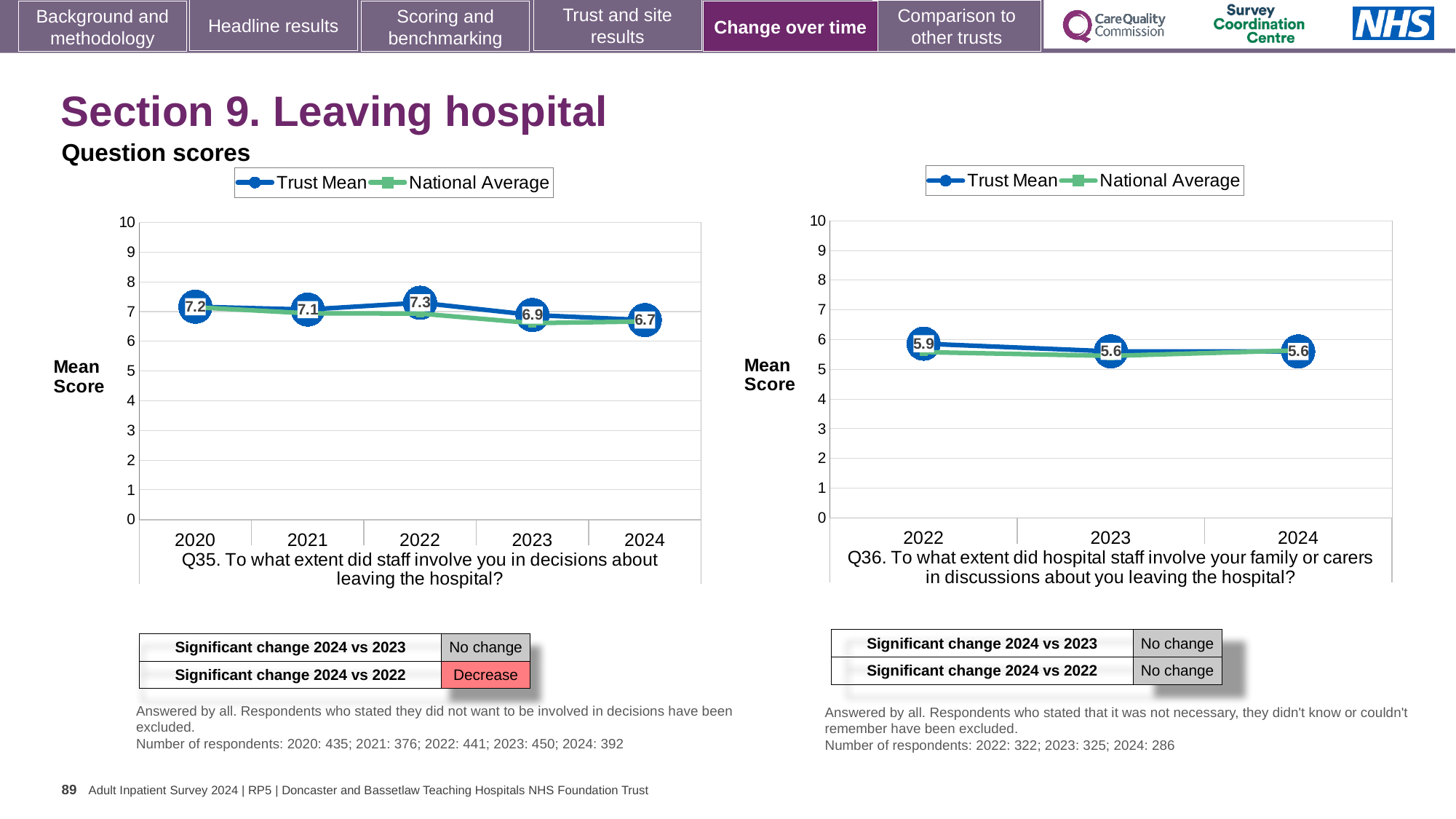
In the Q36 chart, what is the Trust Mean for 2022? 5.9 In the Q35 chart, is the Trust Mean for 2020 or 2023 larger? 2020 In the Q35 chart, what is the Trust Mean for 2022? 7.3 In the Q35 chart, what is the difference between the Trust Mean for 2022 and 2024? 0.6 How many years are shown on the x axis of the Q36 chart? 3 In the Q36 chart, is the National Average for 2022 greater or less than 6? less How many series does the legend of the Q35 chart list? 2 In the Q35 chart, what is the Trust Mean for 2024? 6.7 In the Q35 chart, which year has the highest Trust Mean? 2022 What kind of chart is the Q35 chart? Line chart In the Q35 chart, which year has the lowest Trust Mean? 2024 In the Q36 chart, what is the difference between the Trust Mean for 2022 and 2023? 0.3